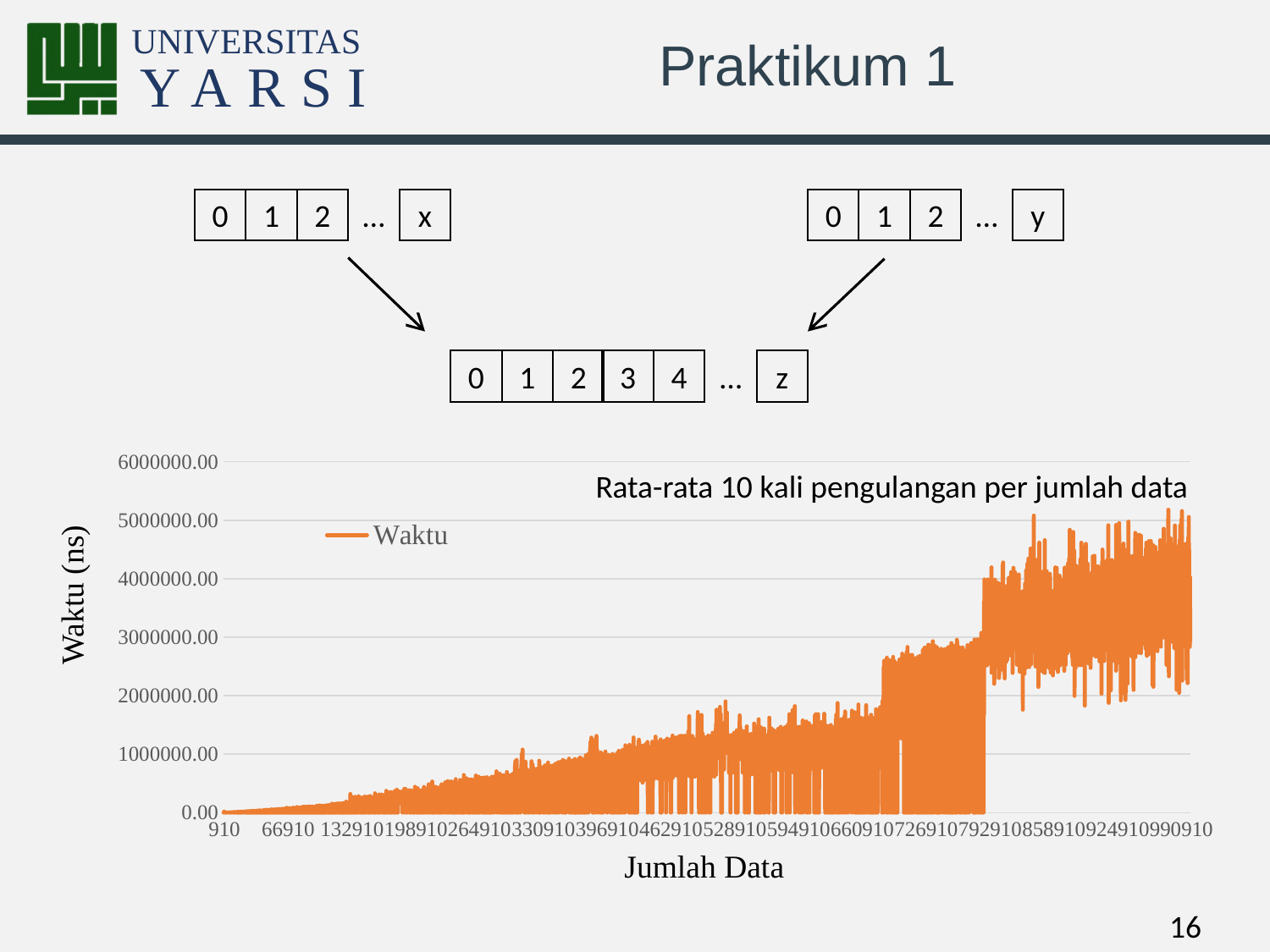
What kind of chart is shown on the slide? line chart Is the value for Jumlah Data 910 greater or less than 1000000.00? less What is the name of the series shown in the chart legend? Waktu Do the plotted values generally rise or fall as Jumlah Data increases along the x axis? rise What is the title of the chart's vertical axis? Waktu (ns) Which is larger, the value at Jumlah Data 910 or the value at Jumlah Data 990910? 990910 Is the value for Jumlah Data 198910 greater or less than 2000000.00? less Is the value for Jumlah Data 66910 greater or less than 1000000.00? less How many series does the chart legend list? 1 Which is larger, the value at Jumlah Data 132910 or the value at Jumlah Data 858910? 858910